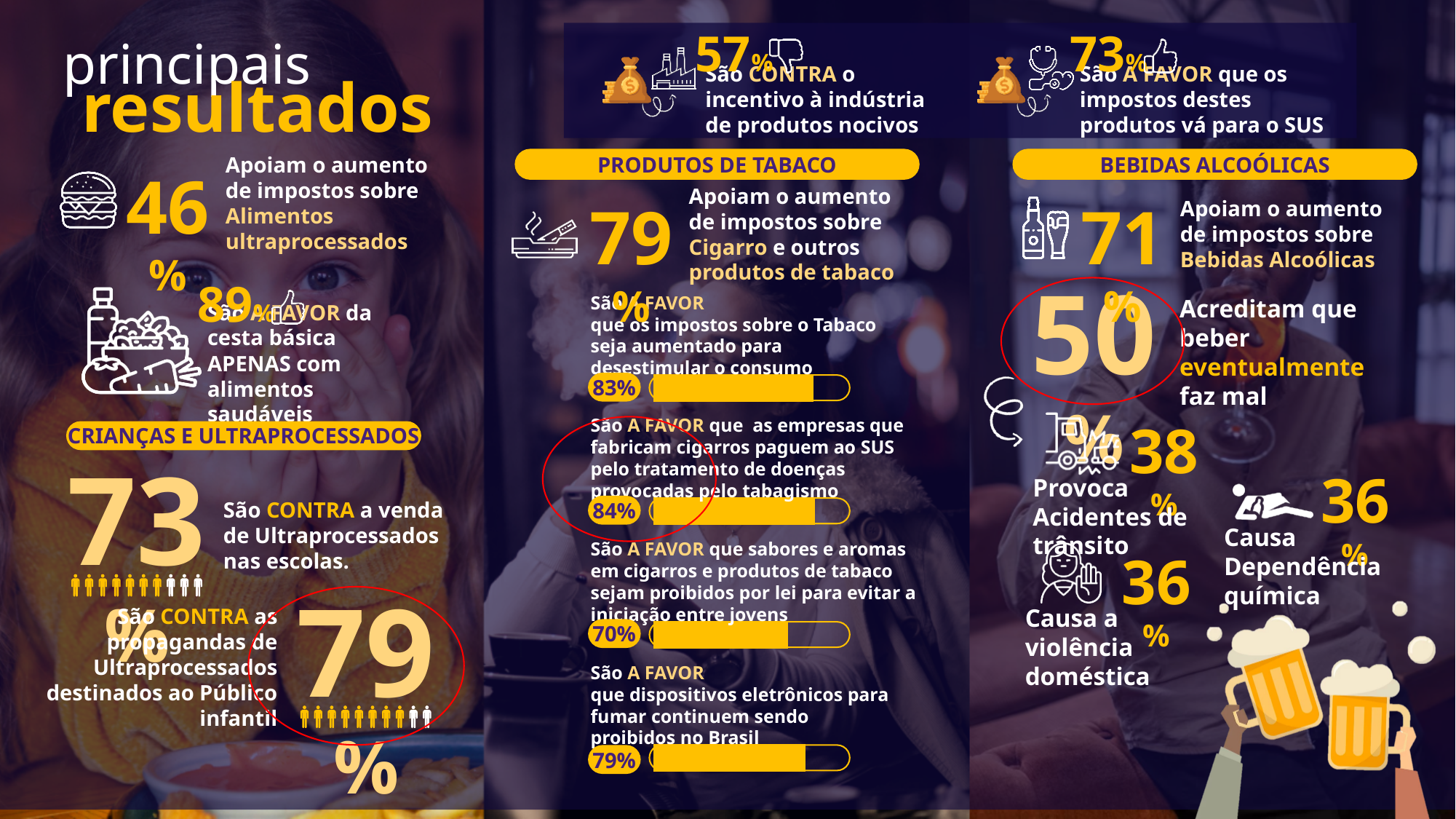
In the 'PRODUTOS DE TABACO' section, what percentage are in favour of electronic smoking devices remaining banned in Brazil? 79% In the 'PRODUTOS DE TABACO' section, what is the difference between the highest and lowest progress-bar percentages? 14 percentage points In the 'PRODUTOS DE TABACO' section, which is larger: the percentage in favour of raising tobacco taxes or the percentage in favour of banning flavours and aromas? Raising tobacco taxes (83%) How many progress bars are shown in the 'PRODUTOS DE TABACO' section? 4 In the 'CRIANÇAS E ULTRAPROCESSADOS' section, what percentage are against advertising of ultra-processed foods aimed at children? 79% In the 'CRIANÇAS E ULTRAPROCESSADOS' section, what percentage are against the sale of ultra-processed foods in schools? 73% Among the four progress bars in the 'PRODUTOS DE TABACO' section, which statement has the highest percentage? Cigarette manufacturers paying the SUS for treatment of smoking-related diseases (84%) Among the four progress bars in the 'PRODUTOS DE TABACO' section, which statement has the lowest percentage? Banning flavours and aromas in cigarettes and tobacco products (70%) What kind of visual is used to show the percentages in the 'PRODUTOS DE TABACO' section? Horizontal progress bars (bar chart) In the 'PRODUTOS DE TABACO' section, what percentage are in favour of cigarette manufacturers paying the SUS for treatment of smoking-related diseases? 84% In the 'PRODUTOS DE TABACO' section, what percentage are in favour of banning flavours and aromas in cigarettes and tobacco products by law? 70% In the 'PRODUTOS DE TABACO' section, what percentage are in favour of raising taxes on tobacco to discourage consumption? 83%